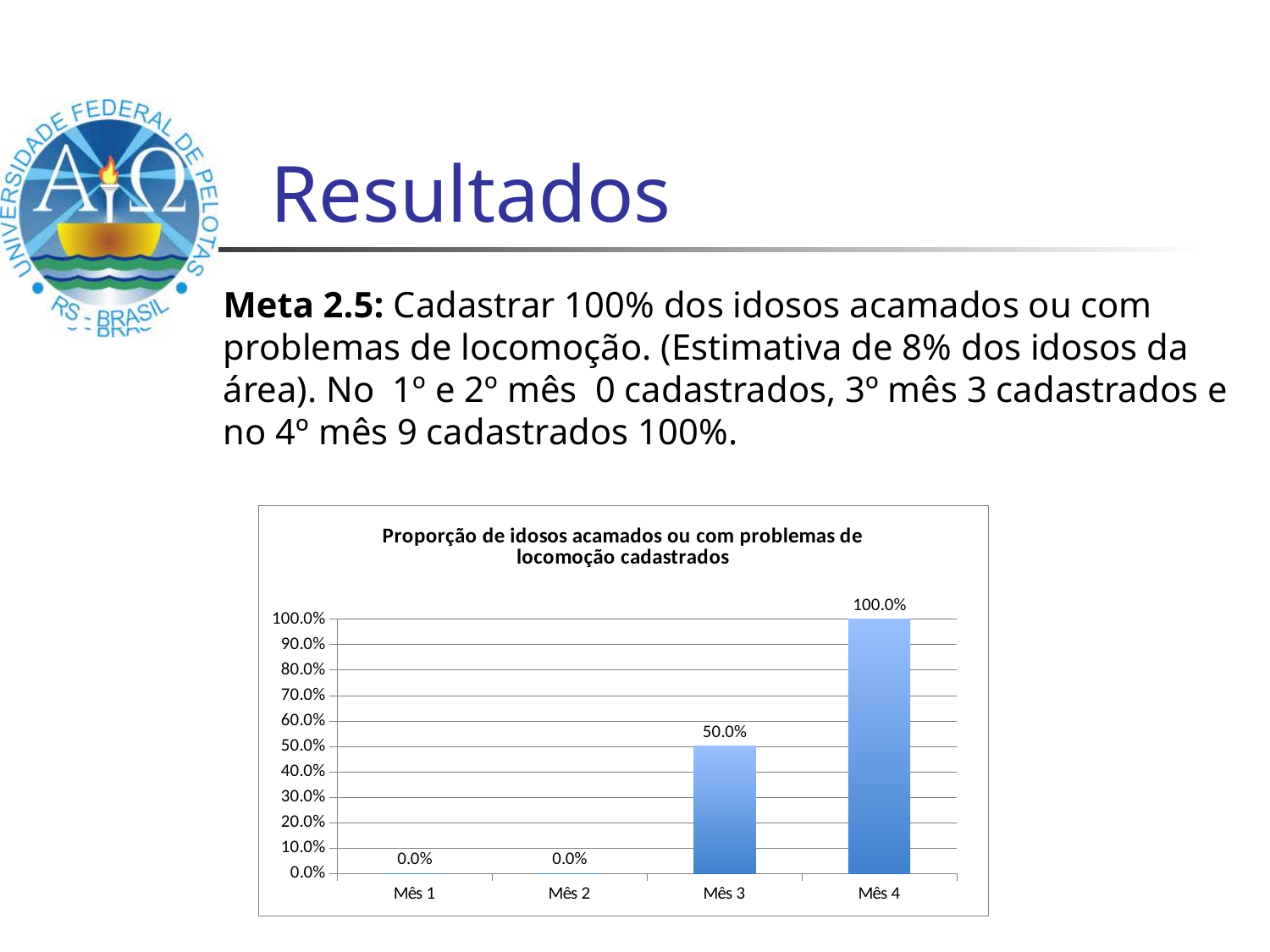
What is the value for Mês 3? 50.0% What is the value for Mês 1? 0.0% What kind of chart is shown on the slide? bar chart Which is larger, the value for Mês 3 or the value for Mês 2? Mês 3 What is the difference between the values for Mês 4 and Mês 3? 50.0% Is the value for Mês 3 greater or less than 40.0%? greater What is the highest value shown on the y axis? 100.0% How many months are shown on the x axis? 4 Do the values rise or fall from Mês 1 to Mês 4? rise Which month has the highest value? Mês 4 What is the value for Mês 4? 100.0% What is the title of the chart? Proporção de idosos acamados ou com problemas de locomoção cadastrados